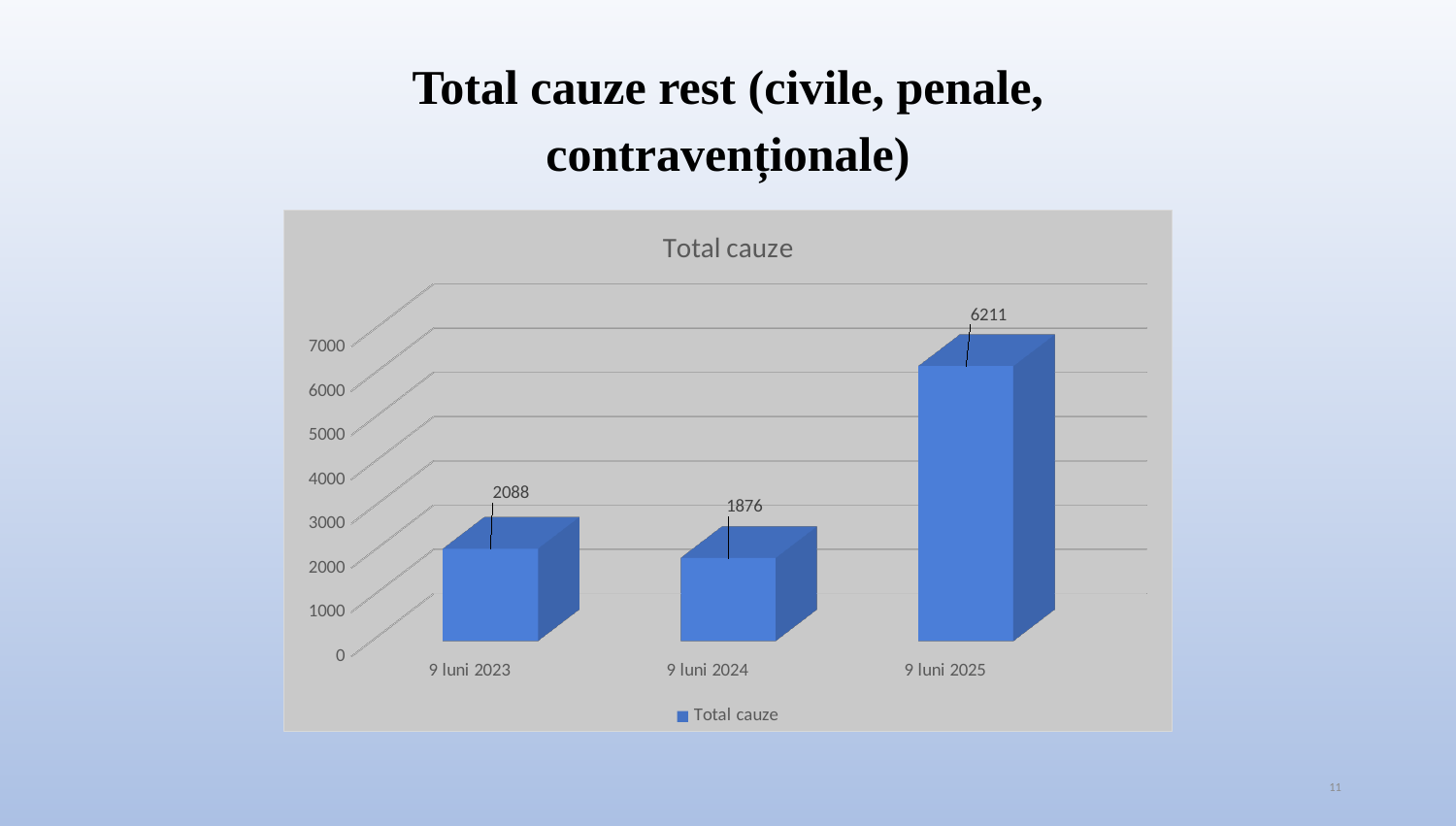
What is the value for 9 luni 2025? 6211 Which category has the highest value? 9 luni 2025 What is the value for 9 luni 2024? 1876 Which category has the lowest value? 9 luni 2024 What is the value for 9 luni 2023? 2088 Which is larger, the value for 9 luni 2023 or 9 luni 2024? 9 luni 2023 What is the difference between the values for 9 luni 2023 and 9 luni 2024? 212 How many categories are shown on the x axis? 3 How many series does the legend list? 1 What kind of chart is shown? bar chart What is the difference between the values for 9 luni 2025 and 9 luni 2023? 4123 What is the title of the chart? Total cauze